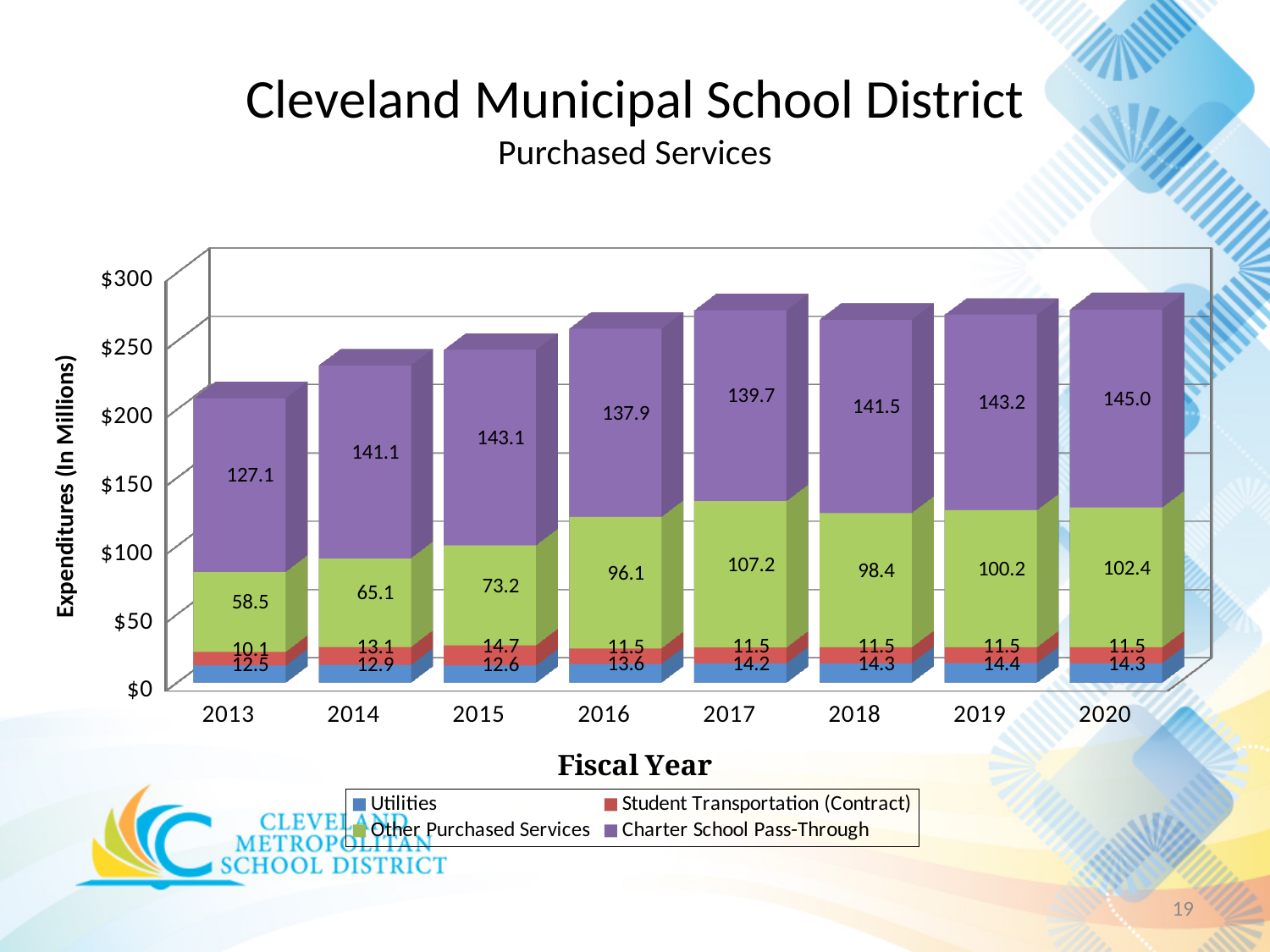
How many fiscal years are shown on the x axis? 8 What is the total of the stacked bar for 2013? 208.2 Which fiscal year has the highest Charter School Pass-Through value? 2020 How many series does the legend list? 4 What is the Charter School Pass-Through value for 2013? 127.1 Which fiscal year has the lowest Other Purchased Services value? 2013 What is the Other Purchased Services value for 2017? 107.2 What is the difference between the Charter School Pass-Through values for 2020 and 2013? 17.9 Which is larger, the Other Purchased Services value for 2017 or for 2018? 2017 What type of chart is shown on the slide? Stacked bar chart What is the label of the y axis? Expenditures (In Millions) What is the Utilities value for 2019? 14.4